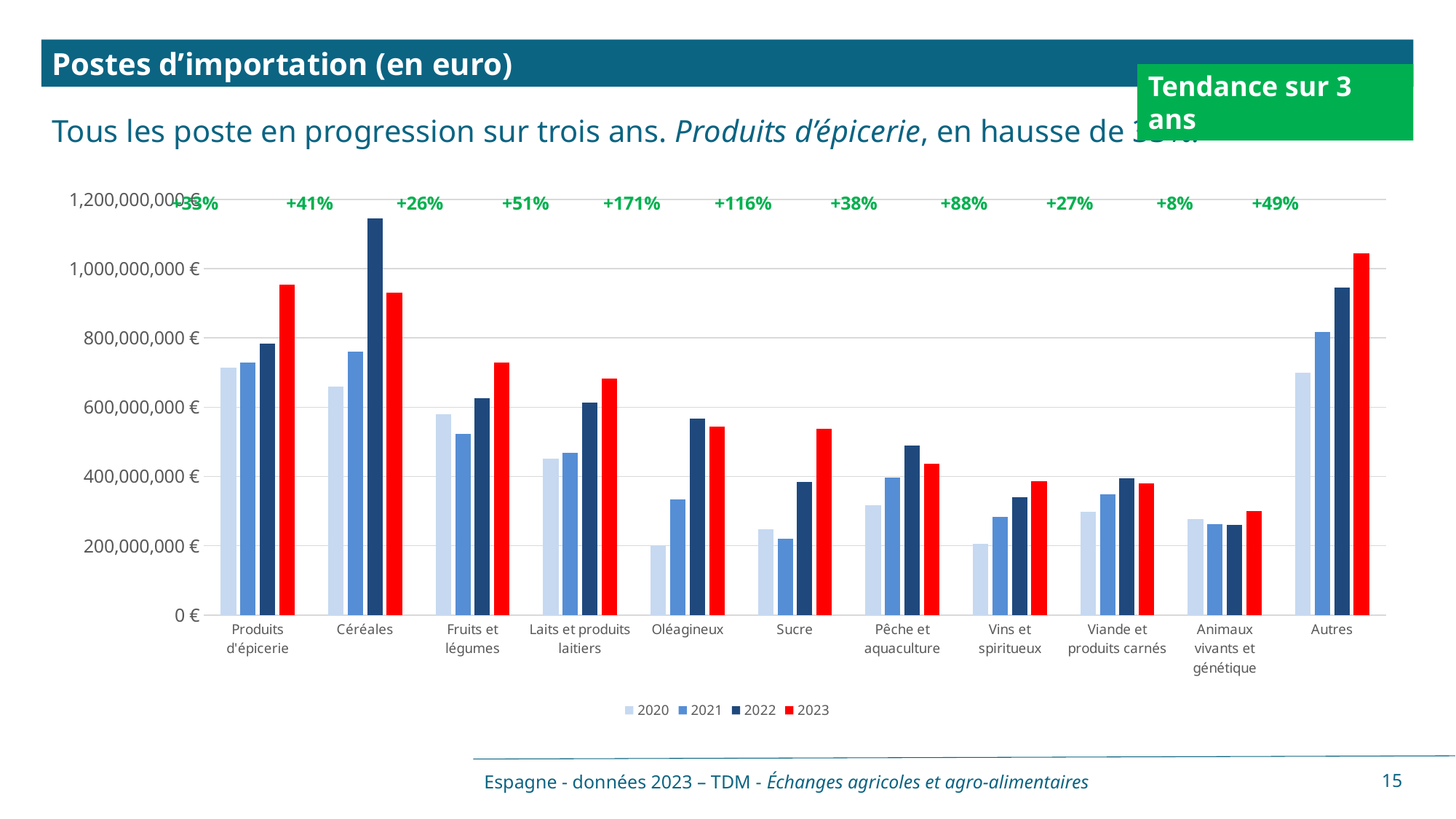
What three-year trend percentage is shown above Animaux vivants et génétique? +8% Is the 2020 value for Sucre greater or less than 400,000,000 €? less How many import categories are shown along the x axis? 11 Is the 2022 value for Céréales greater or less than 1,000,000,000 €? greater Which years are listed in the legend? 2020, 2021, 2022, 2023 What kind of chart is shown on the slide? bar chart Which category has the highest 2023 value? Autres How many series does the legend list? 4 Which category has the lowest 2023 value? Animaux vivants et génétique For Céréales, which is larger: the 2022 value or the 2023 value? 2022 What three-year trend percentage is shown above Sucre? +116% What three-year trend percentage is shown above Oléagineux? +171%